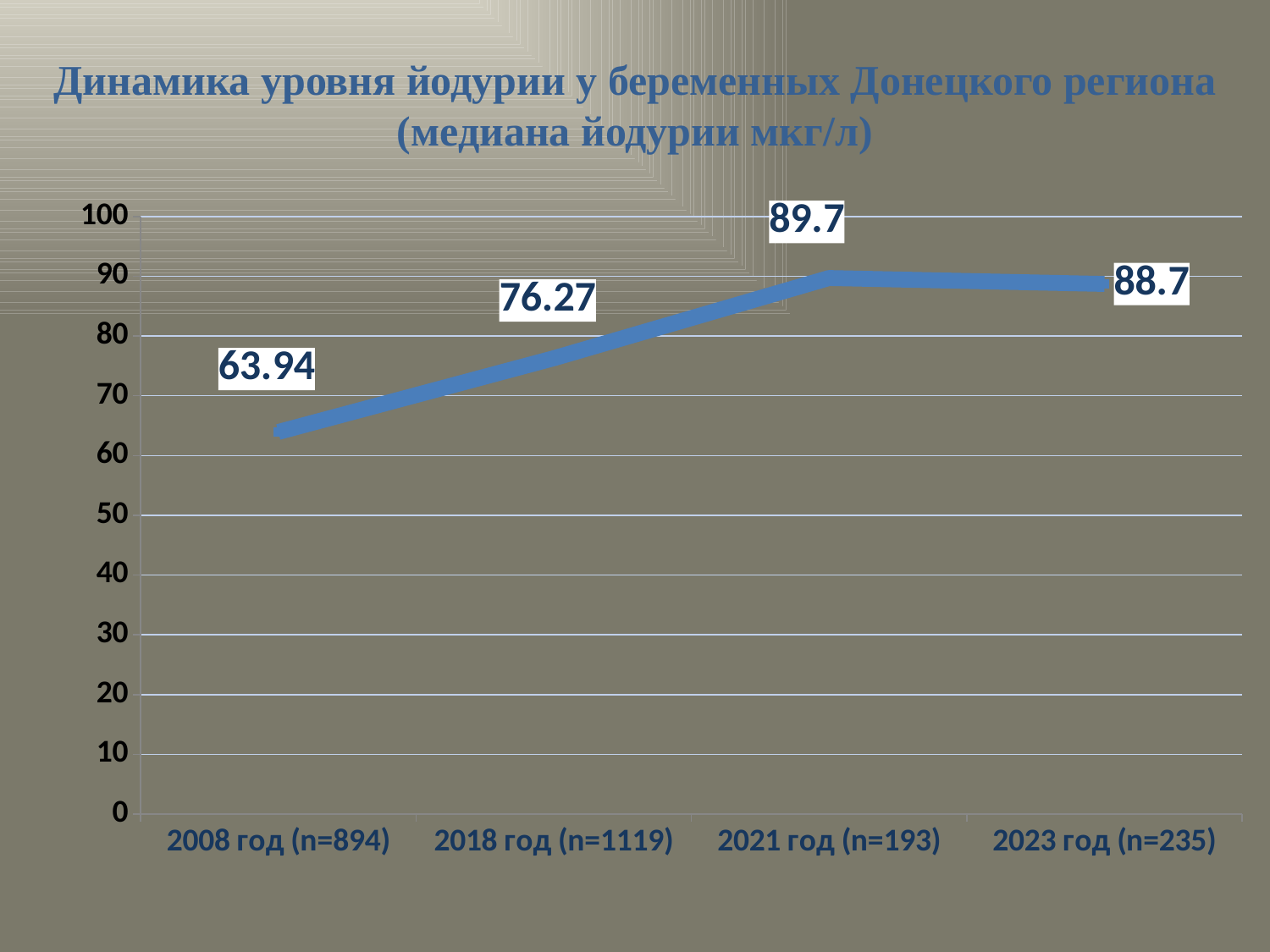
What kind of chart is shown on the slide? Line chart How many data points are plotted on the chart? 4 What is the difference between the values for 2021 год (n=193) and 2023 год (n=235)? 1 What is the median ioduria value for 2021 год (n=193)? 89.7 What is the median ioduria value for 2008 год (n=894)? 63.94 What is the median ioduria value for 2023 год (n=235)? 88.7 What is the median ioduria value for 2018 год (n=1119)? 76.27 Which is larger, the value for 2018 год (n=1119) or the value for 2023 год (n=235)? 2023 год (n=235) What is the difference between the values for 2018 год (n=1119) and 2008 год (n=894)? 12.33 Which year has the highest median ioduria value? 2021 год (n=193) Which year has the lowest median ioduria value? 2008 год (n=894) Does the median ioduria value rise or fall from 2008 to 2021? Rise